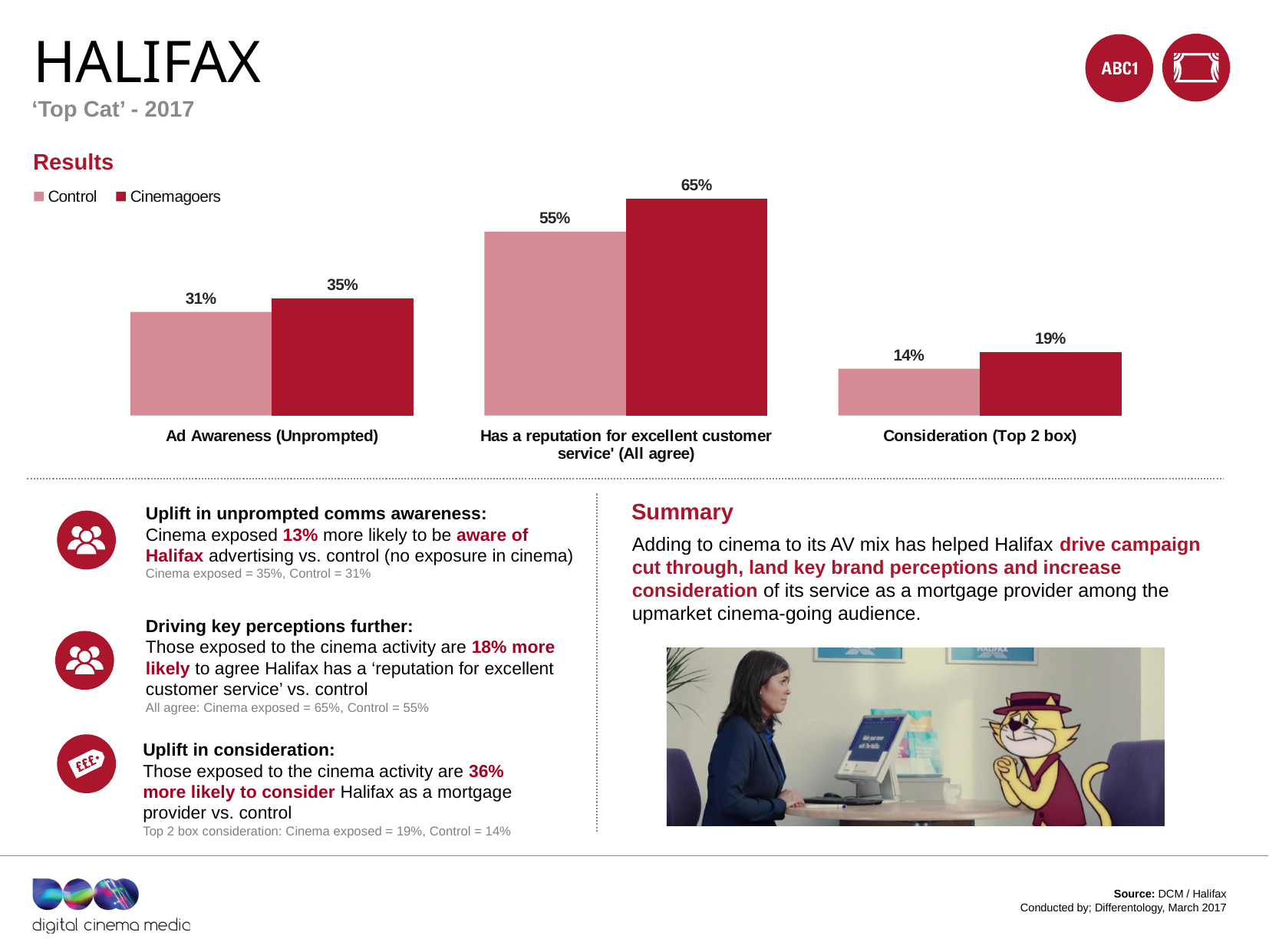
What is the Cinemagoers value for Consideration (Top 2 box)? 19% How many series does the legend list? 2 What is the difference between the Cinemagoers and Control values for Consideration (Top 2 box)? 5% Which category has the highest Cinemagoers value? Has a reputation for excellent customer service' (All agree) Which category has the lowest Control value? Consideration (Top 2 box) What is the Control value for Ad Awareness (Unprompted)? 31% What is the difference between the Cinemagoers and Control values for 'Has a reputation for excellent customer service' (All agree)? 10% How many categories are shown on the chart? 3 What is the Cinemagoers value for Ad Awareness (Unprompted)? 35% Which is larger for Ad Awareness (Unprompted): the Control value or the Cinemagoers value? Cinemagoers What kind of chart is shown on the slide? Bar chart What is the Control value for 'Has a reputation for excellent customer service' (All agree)? 55%